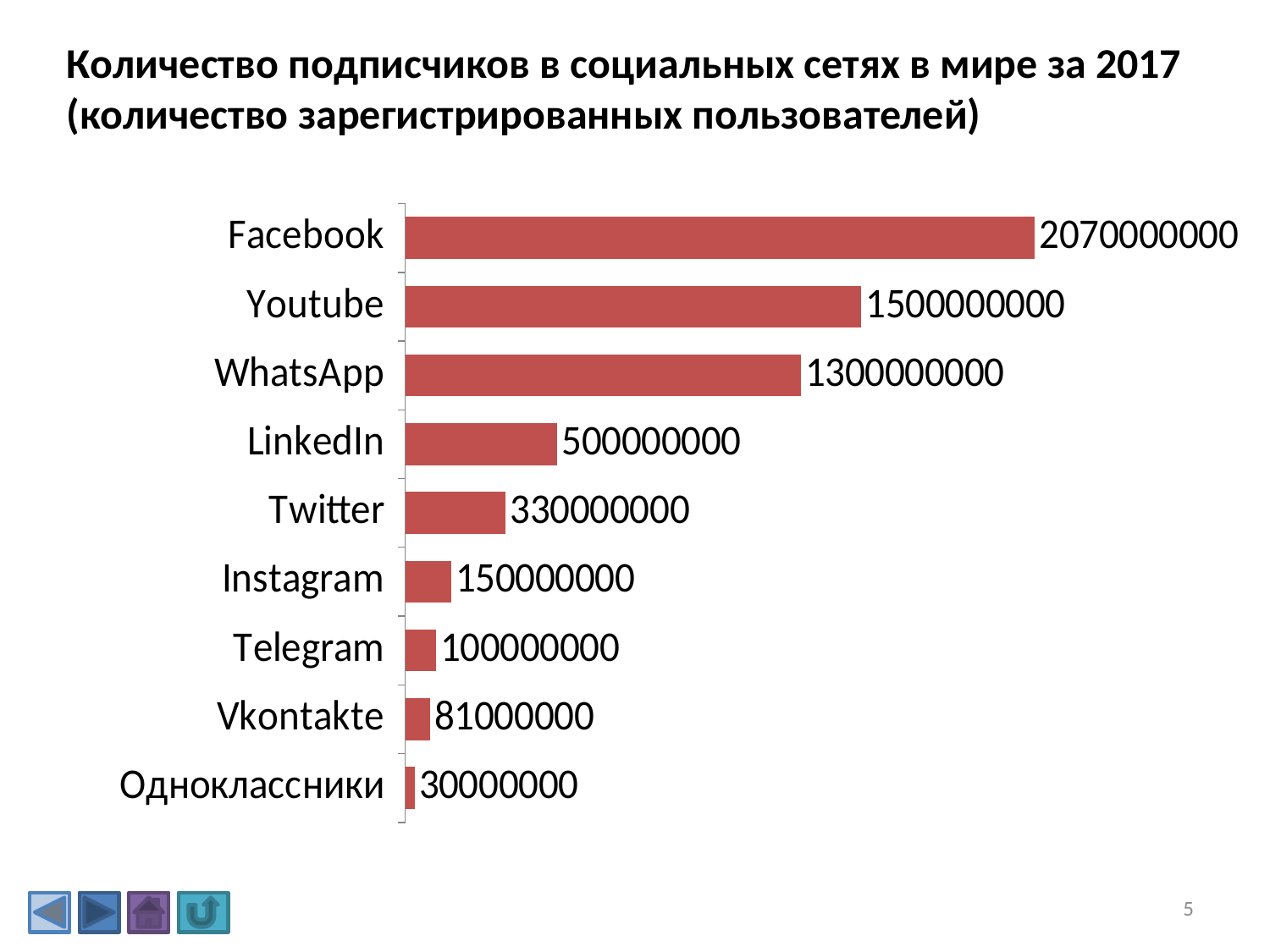
What is the value for Vkontakte? 81000000 What is the value for Twitter? 330000000 What colour are the bars in the chart? Red What is the value for Facebook? 2070000000 What is the difference between the values for LinkedIn and Twitter? 170000000 How many social networks are shown in the chart? 9 What is the value for WhatsApp? 1300000000 Which social network has the highest number of registered users? Facebook Which social network has the lowest number of registered users? Одноклассники What is the difference between the values for Youtube and WhatsApp? 200000000 What kind of chart is shown on the slide? Bar chart Which is larger, the value for Instagram or the value for Telegram? Instagram